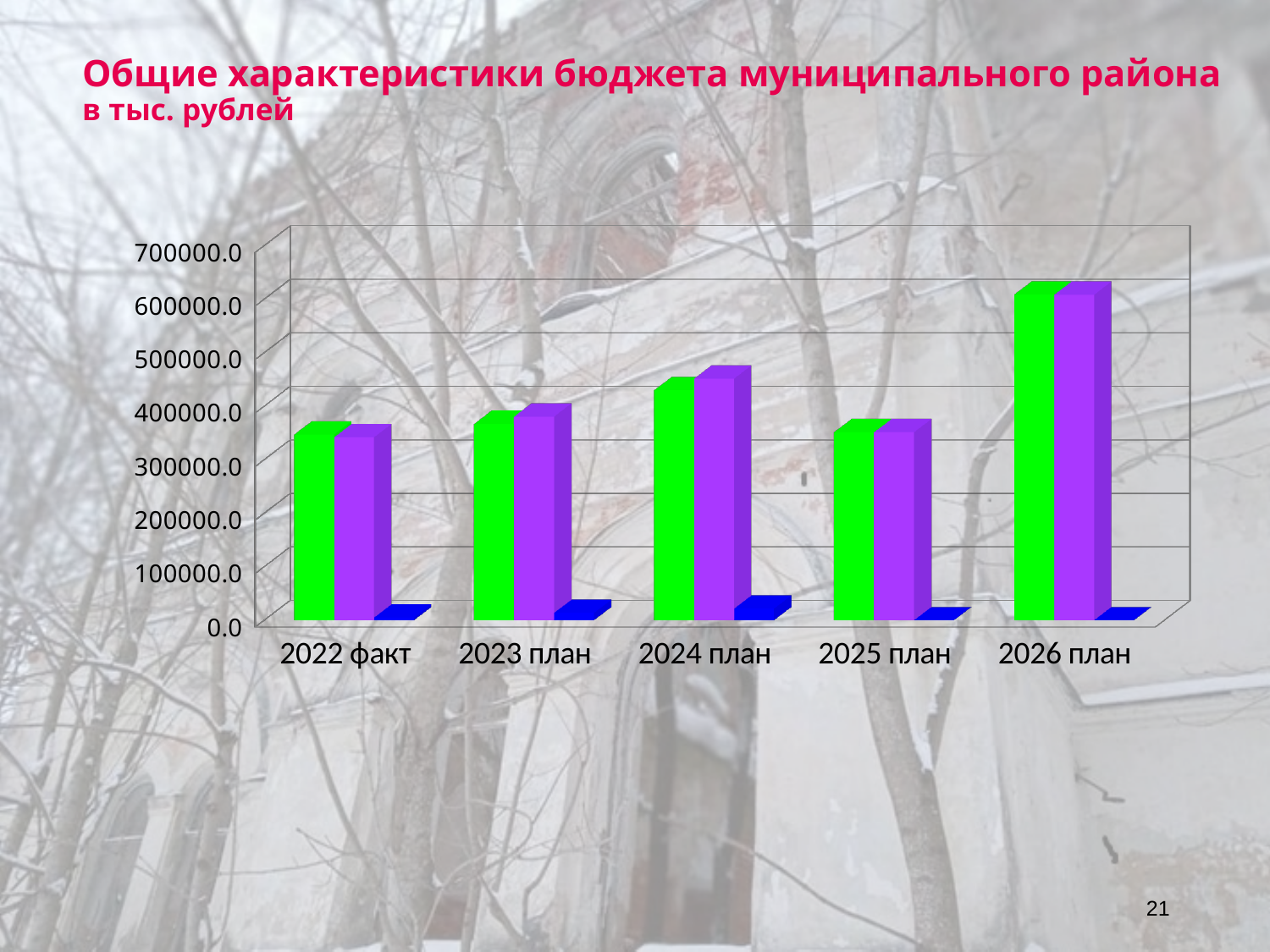
Which is larger, the purple bar for 2026 план or the purple bar for 2024 план? 2026 план Is the blue bar for 2024 план greater or less than 100000.0? less Which category has the tallest purple bar? 2026 план What is the title of the chart on the slide? Общие характеристики бюджета муниципального района в тыс. рублей How many categories are shown along the x axis of the chart? 5 Is the green bar for 2026 план greater or less than 600000.0? greater Which category has the tallest green bar? 2026 план Is the purple bar for 2025 план greater or less than 400000.0? less What kind of chart is shown on the slide? bar chart Which is larger, the green bar for 2024 план or the green bar for 2023 план? 2024 план